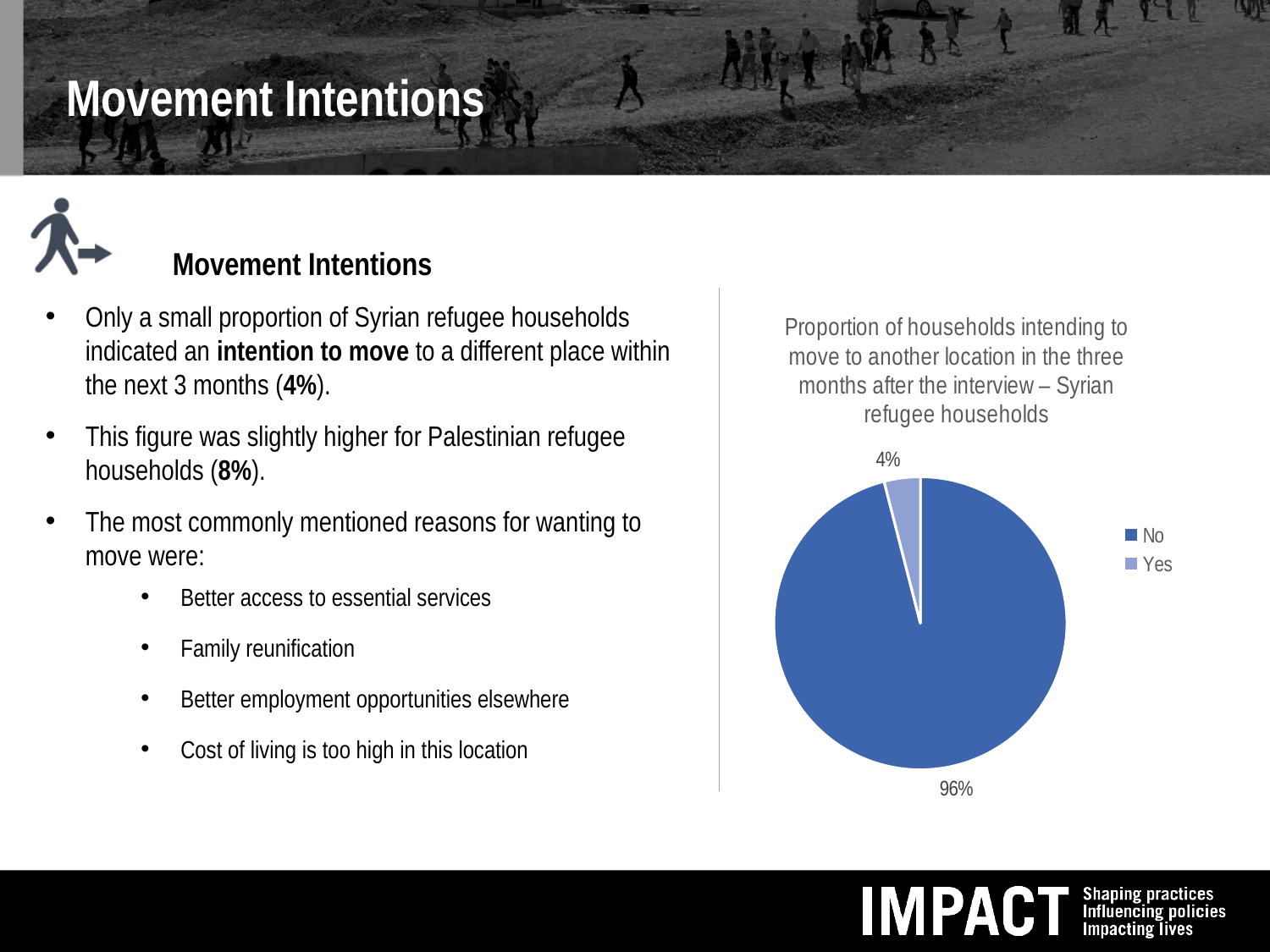
What share of Syrian refugee households answered "Yes" to intending to move? 4% What share of Syrian refugee households answered "No" to intending to move? 96% Which legend entry is shown in the lighter blue colour? Yes Which slice of the pie chart is the smallest? Yes Which slice of the pie chart is the largest? No What is the title of the pie chart? Proportion of households intending to move to another location in the three months after the interview – Syrian refugee households What kind of chart is shown on the slide? pie chart What is the difference in percentage points between the "No" and "Yes" slices? 92 How many entries does the legend list? 2 Which is larger, the "Yes" slice or the "No" slice? No How many slices does the pie chart have? 2